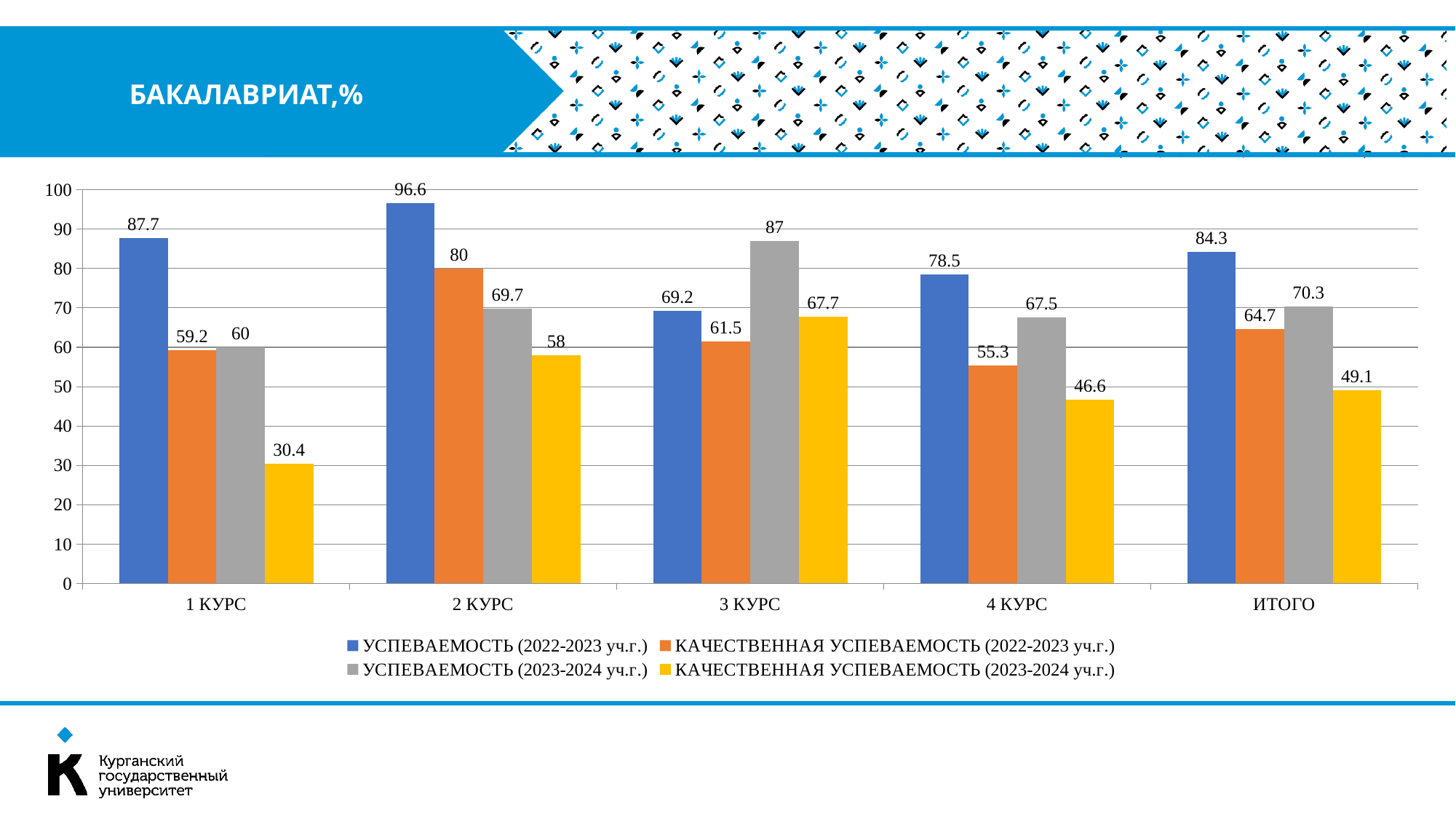
What is the difference between УСПЕВАЕМОСТЬ (2022-2023 уч.г.) and УСПЕВАЕМОСТЬ (2023-2024 уч.г.) for 4 КУРС? 11 What kind of chart is shown on the slide? Bar chart For 3 КУРС, which is larger: УСПЕВАЕМОСТЬ (2022-2023 уч.г.) or УСПЕВАЕМОСТЬ (2023-2024 уч.г.)? УСПЕВАЕМОСТЬ (2023-2024 уч.г.) What is the value of УСПЕВАЕМОСТЬ (2022-2023 уч.г.) for 2 КУРС? 96.6 What is the title shown in the header of the slide? БАКАЛАВРИАТ,% What is the value of КАЧЕСТВЕННАЯ УСПЕВАЕМОСТЬ (2022-2023 уч.г.) for ИТОГО? 64.7 Which category has the highest value for УСПЕВАЕМОСТЬ (2022-2023 уч.г.)? 2 КУРС What is the value of КАЧЕСТВЕННАЯ УСПЕВАЕМОСТЬ (2023-2024 уч.г.) for 1 КУРС? 30.4 How many categories are shown on the x axis? 5 Which category has the lowest value for КАЧЕСТВЕННАЯ УСПЕВАЕМОСТЬ (2023-2024 уч.г.)? 1 КУРС How many series does the legend list? 4 What is the value of УСПЕВАЕМОСТЬ (2023-2024 уч.г.) for 3 КУРС? 87